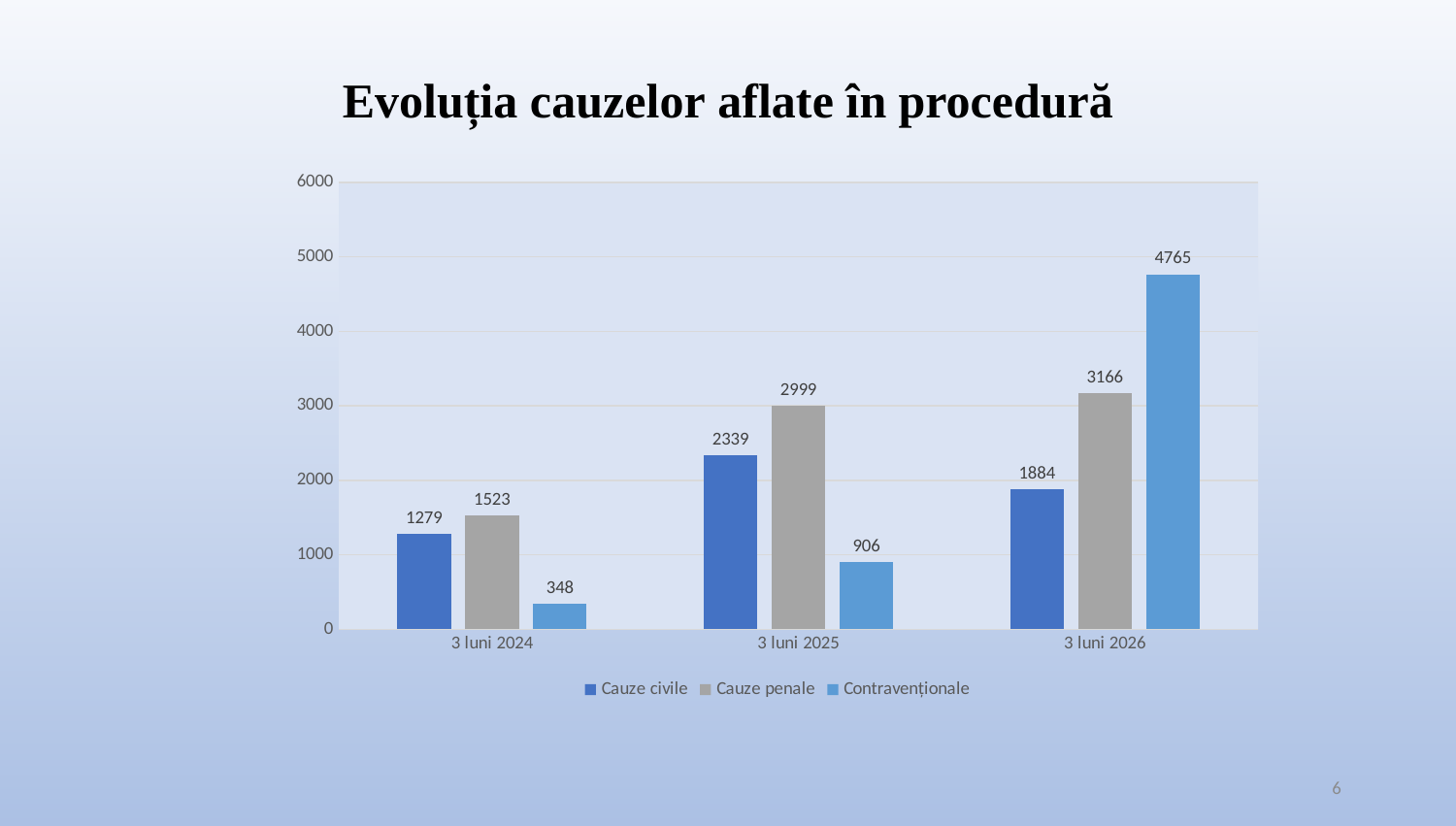
Do the values for Contravenționale rise or fall from 3 luni 2024 to 3 luni 2026? rise What is the value for Cauze penale in 3 luni 2025? 2999 What is the value for Cauze civile in 3 luni 2024? 1279 Is the value for Contravenționale in 3 luni 2025 greater or less than 1000? less How many series does the legend list? 3 Which is larger in 3 luni 2026: Cauze civile or Cauze penale? Cauze penale Which period has the lowest value for Contravenționale? 3 luni 2024 What is the value for Contravenționale in 3 luni 2026? 4765 What kind of chart is shown on the slide? bar chart What is the difference between Cauze penale and Cauze civile in 3 luni 2024? 244 How many periods are shown on the x axis? 3 Which period has the highest value for Cauze penale? 3 luni 2026